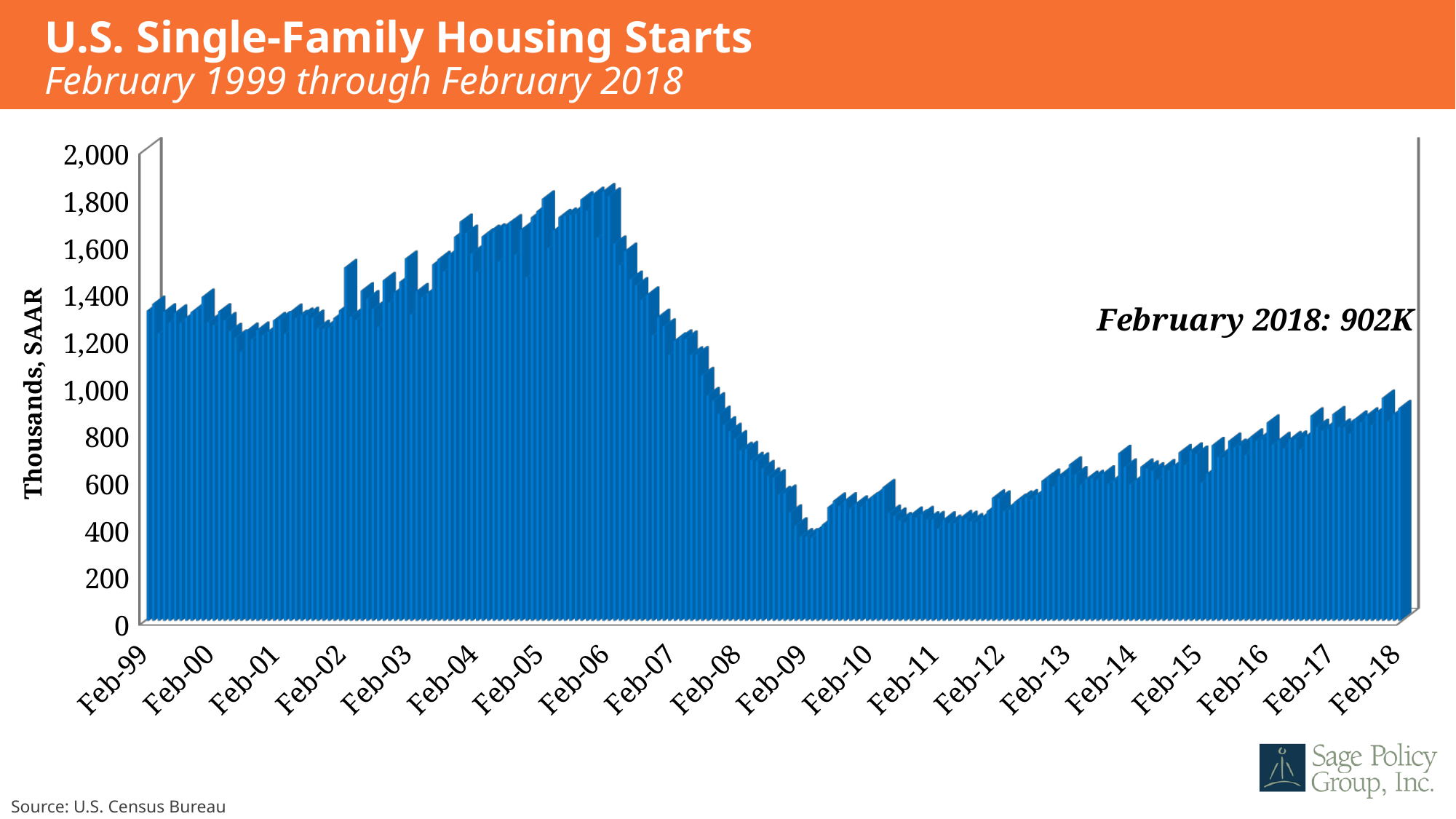
Which is larger, the value for Feb-05 or the value for Feb-10? Feb-05 Is the value for Feb-12 greater or less than 800? less Is the value for Feb-06 greater or less than 1,600? greater What kind of chart is shown on the slide? bar chart What is the label on the vertical axis of the chart? Thousands, SAAR Do housing starts rise or fall between Feb-11 and Feb-18? rise What value is printed on the chart for February 2018? 902K Around which labelled year do housing starts reach their lowest level? Feb-09 Is the value for Feb-09 greater or less than 600? less Do housing starts rise or fall between Feb-06 and Feb-09? fall Around which labelled year do housing starts reach their highest level? Feb-06